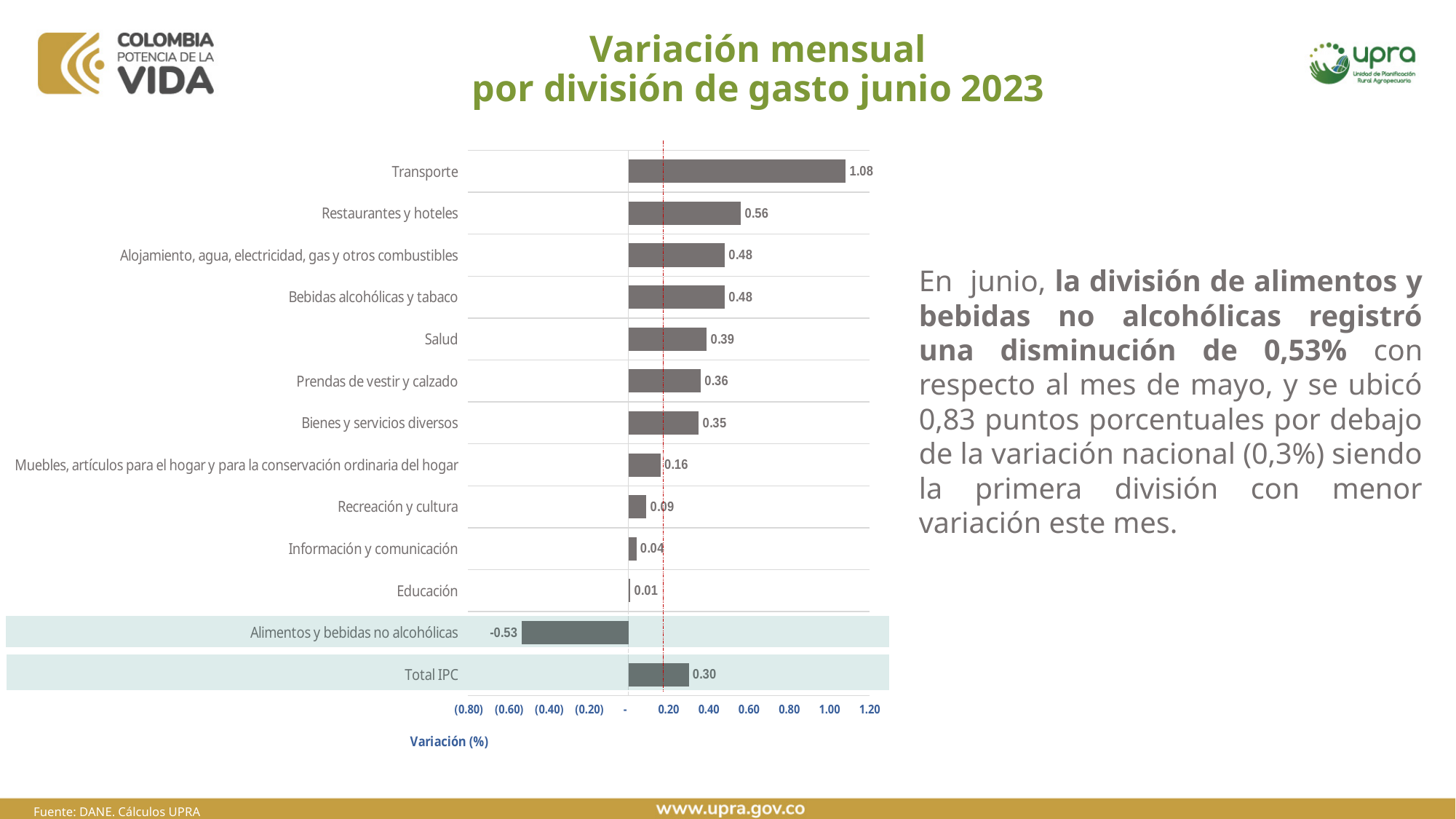
What is the difference between the values for Transporte and Restaurantes y hoteles? 0.52 What is the value for Total IPC? 0.30 What is the value for Salud? 0.39 What is the value for Transporte? 1.08 Which is larger, the value for Prendas de vestir y calzado or the value for Recreación y cultura? Prendas de vestir y calzado What is the title of the chart? Variación mensual por división de gasto junio 2023 What is the label of the horizontal axis? Variación (%) Which category has the lowest value? Alimentos y bebidas no alcohólicas What is the value for Alimentos y bebidas no alcohólicas? -0.53 What kind of chart is shown on the slide? Bar chart Which category has the highest value? Transporte How many categories are shown in the chart? 13